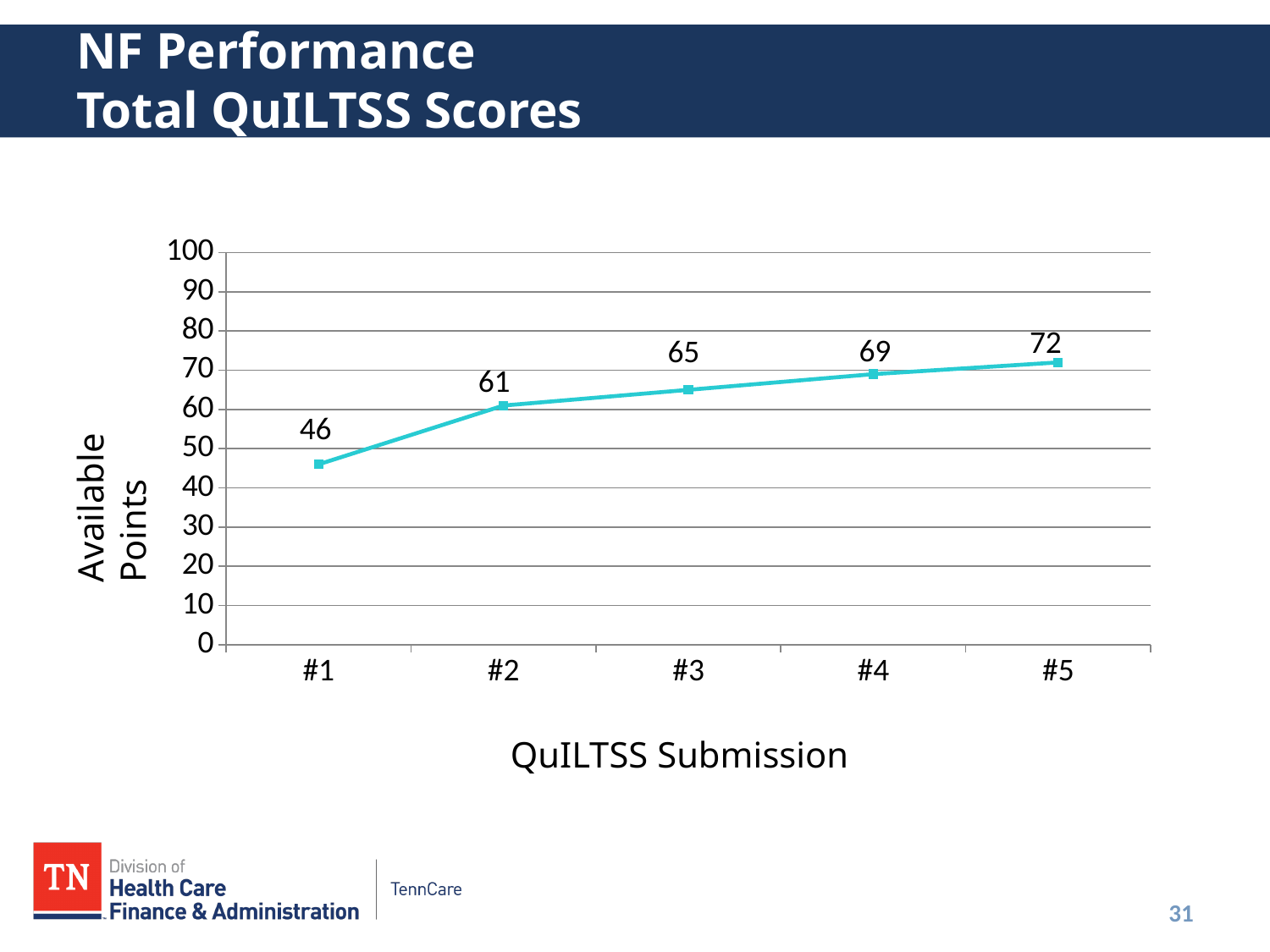
Which QuILTSS Submission has the highest value? #5 Do the values rise or fall from Submission #1 to Submission #5? rise How many QuILTSS Submissions are plotted on the chart? 5 What is the value for QuILTSS Submission #1? 46 What is the difference between the values for Submission #5 and Submission #4? 3 What is the difference between the values for Submission #2 and Submission #1? 15 Is the value for Submission #3 greater or less than 60? greater What is the value for QuILTSS Submission #5? 72 Which is larger, the value for Submission #2 or Submission #4? #4 What kind of chart is shown on the slide? line chart Which QuILTSS Submission has the lowest value? #1 What is the value for QuILTSS Submission #3? 65